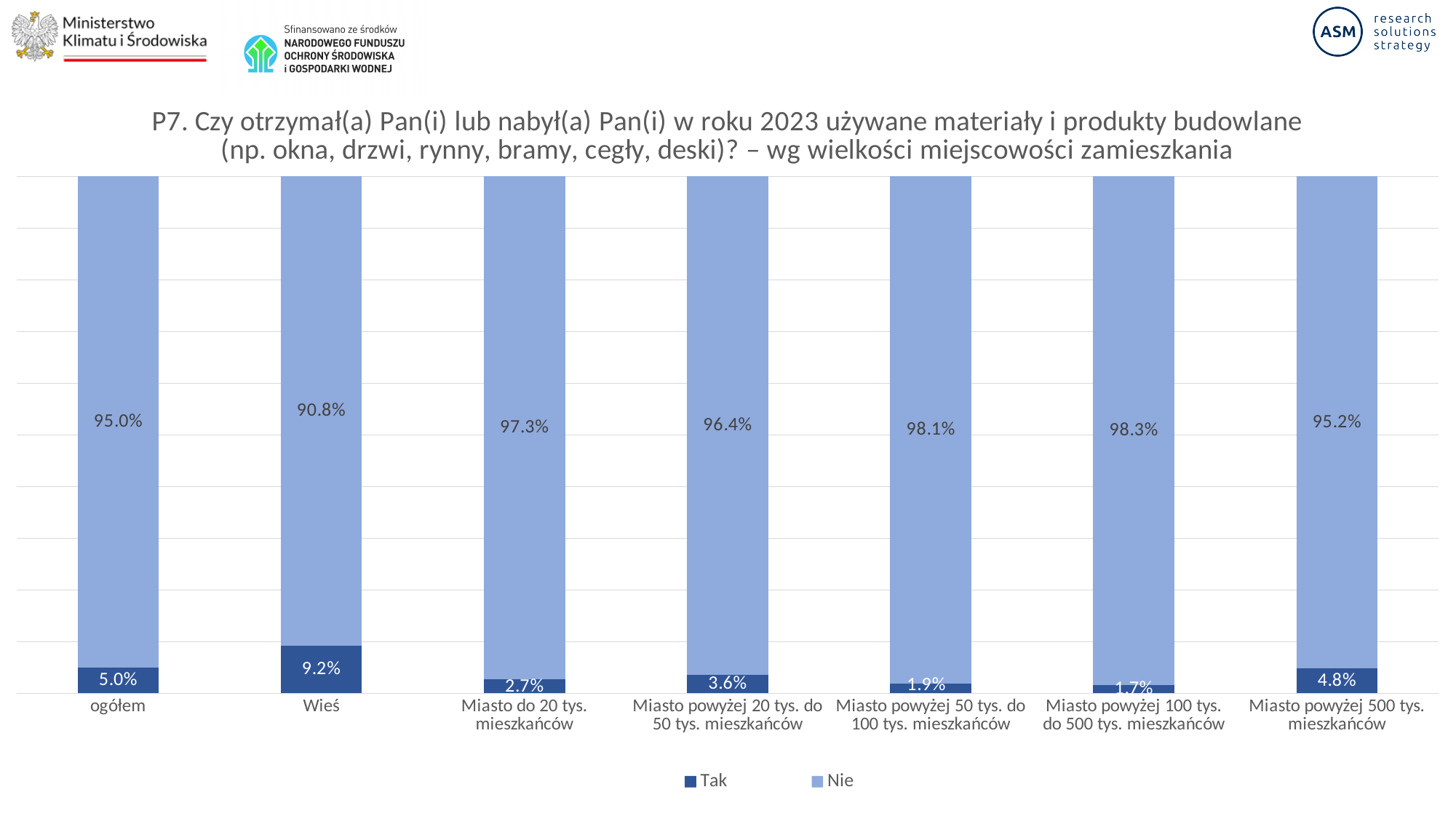
What is the "Tak" value for Miasto powyżej 500 tys. mieszkańców? 4.8% What is the "Nie" value for Miasto powyżej 50 tys. do 100 tys. mieszkańców? 98.1% What is the total of the stacked bar for Miasto powyżej 100 tys. do 500 tys. mieszkańców? 100.0% Which category has the lowest "Tak" value? Miasto powyżej 100 tys. do 500 tys. mieszkańców Which has a larger "Tak" value: Miasto do 20 tys. mieszkańców or Miasto powyżej 20 tys. do 50 tys. mieszkańców? Miasto powyżej 20 tys. do 50 tys. mieszkańców What kind of chart is shown on the slide? Stacked bar chart What is the "Nie" value for ogółem? 95.0% Which category has the highest "Tak" value? Wieś What is the "Tak" value for Wieś? 9.2% How many series does the legend list? 2 What is the difference between the "Tak" values for Wieś and ogółem? 4.2% How many categories are shown on the x axis? 7